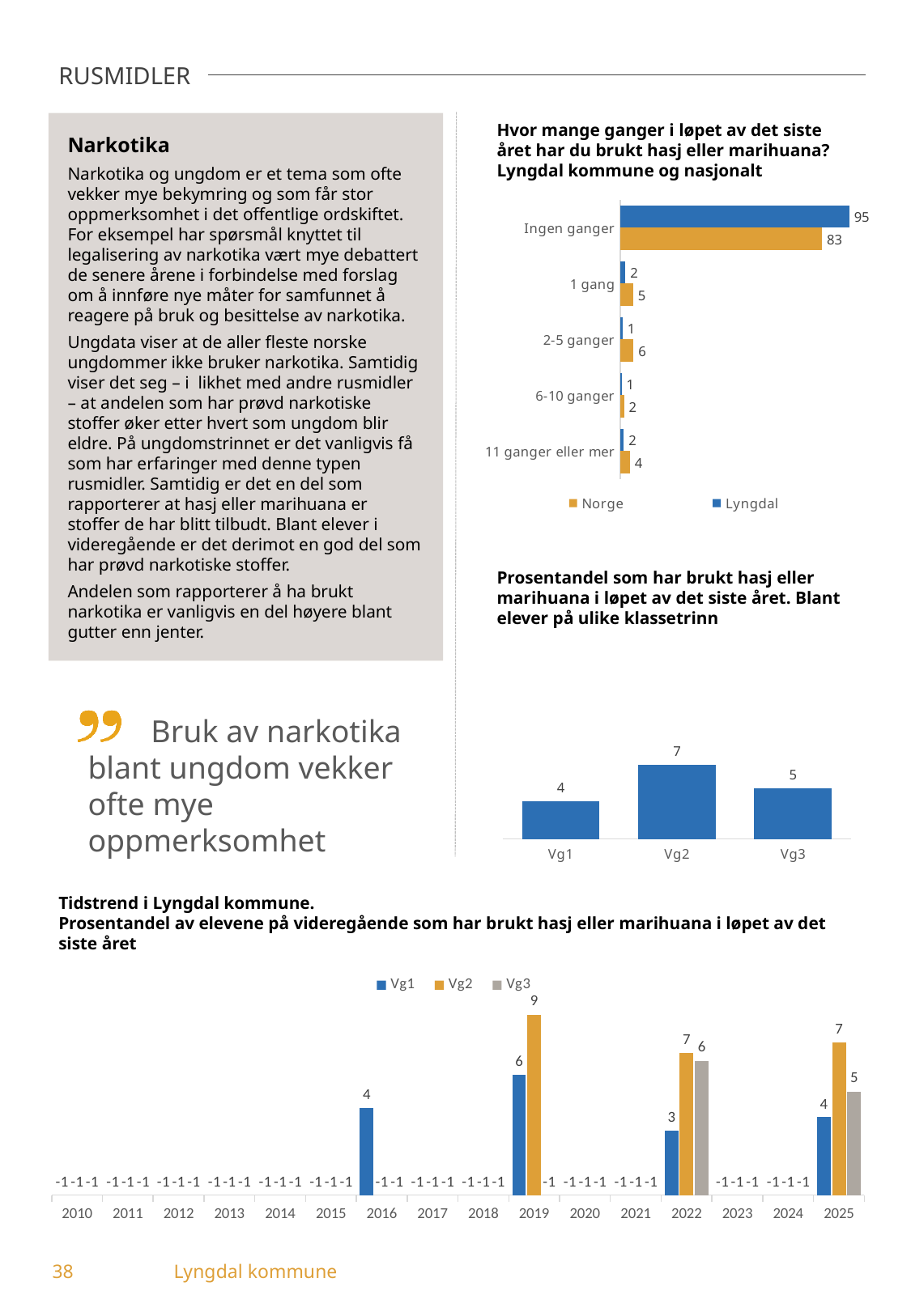
In the chart 'Hvor mange ganger i løpet av det siste året har du brukt hasj eller marihuana?', what is the value for Norge in the category '2-5 ganger'? 6 In the chart 'Tidstrend i Lyngdal kommune', which series is shown in orange according to the legend? Vg2 In the chart 'Hvor mange ganger i løpet av det siste året har du brukt hasj eller marihuana?', what is the difference between the Lyngdal and Norge values for 'Ingen ganger'? 12 In the chart 'Prosentandel som har brukt hasj eller marihuana i løpet av det siste året. Blant elever på ulike klassetrinn', what is the value for Vg3? 5 In the chart 'Tidstrend i Lyngdal kommune', what is the value for Vg2 in 2019? 9 What kind of chart is 'Prosentandel som har brukt hasj eller marihuana i løpet av det siste året. Blant elever på ulike klassetrinn'? Bar chart In the chart 'Prosentandel som har brukt hasj eller marihuana i løpet av det siste året. Blant elever på ulike klassetrinn', which class level has the highest value? Vg2 In the chart 'Tidstrend i Lyngdal kommune', which is larger in 2022: Vg2 or Vg3? Vg2 In the chart 'Hvor mange ganger i løpet av det siste året har du brukt hasj eller marihuana?', how many series does the legend list? 2 In the chart 'Hvor mange ganger i løpet av det siste året har du brukt hasj eller marihuana?', what is the value for Lyngdal in the category 'Ingen ganger'? 95 In the chart 'Tidstrend i Lyngdal kommune', what is the difference between Vg2 and Vg1 in 2025? 3 In the chart 'Hvor mange ganger i løpet av det siste året har du brukt hasj eller marihuana?', how many categories are shown? 5